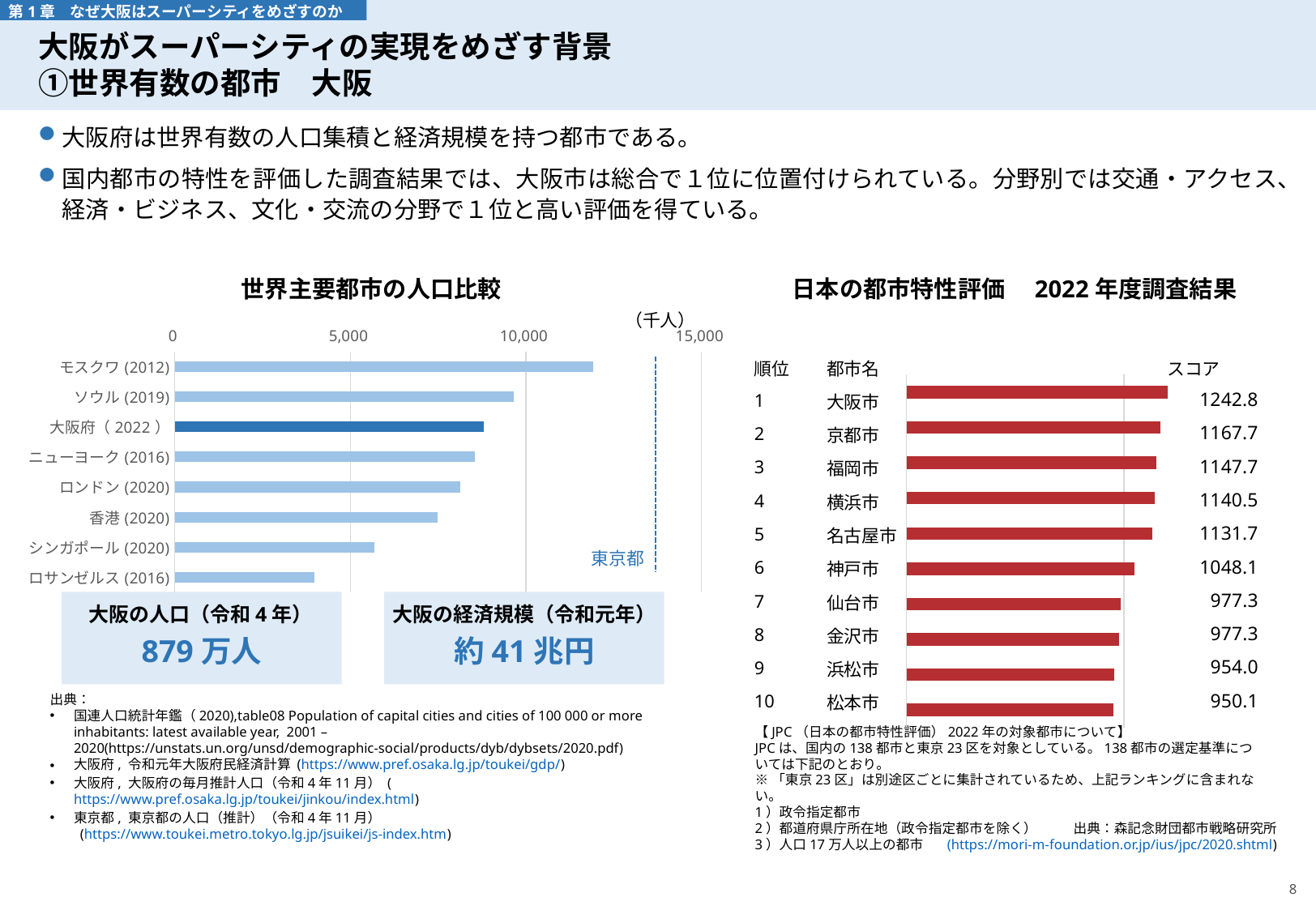
In the chart titled 日本の都市特性評価 2022年度調査結果, which city has the highest score? 大阪市 In the chart titled 世界主要都市の人口比較, is the value for 大阪府 (2022) greater or less than 10,000? less In the chart titled 世界主要都市の人口比較, how many cities are shown as bars? 8 In the chart titled 日本の都市特性評価 2022年度調査結果, which city has the lowest score? 松本市 In the chart titled 日本の都市特性評価 2022年度調査結果, what is the score for 神戸市? 1048.1 In the chart titled 日本の都市特性評価 2022年度調査結果, what is the difference between the scores of 大阪市 and 京都市? 75.1 In the chart titled 世界主要都市の人口比較, which city has the smallest population bar? ロサンゼルス (2016) In the chart titled 日本の都市特性評価 2022年度調査結果, what is the score for 大阪市? 1242.8 In the chart titled 日本の都市特性評価 2022年度調査結果, what is the difference between the scores of 横浜市 and 名古屋市? 8.8 In the chart titled 世界主要都市の人口比較, which city has the largest population bar? モスクワ (2012) In the chart titled 日本の都市特性評価 2022年度調査結果, how many cities are ranked? 10 What kind of chart is the chart titled 世界主要都市の人口比較? bar chart